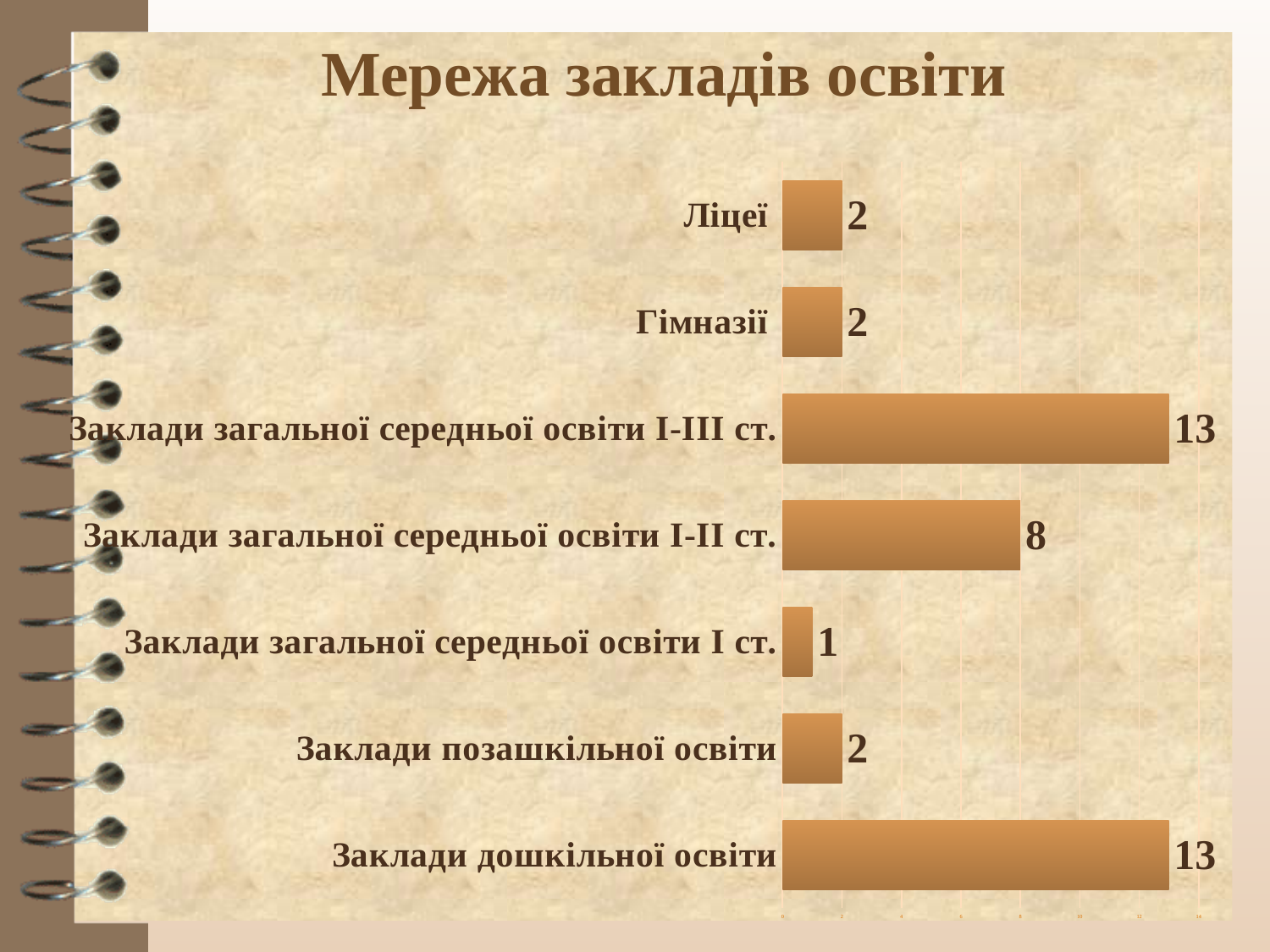
What is the value for Заклади дошкільної освіти? 13 What is the title of the chart? Мережа закладів освіти What is the difference between Заклади загальної середньої освіти І-ІІІ ст. and Заклади загальної середньої освіти І-ІІ ст.? 5 What is the value for Гімназії? 2 How many categories are shown in the chart? 7 What is the value for Заклади загальної середньої освіти І-ІІ ст.? 8 What is the highest value shown in the chart? 13 What is the value for Заклади загальної середньої освіти І ст.? 1 What is the value for Ліцеї? 2 Which is larger: Заклади загальної середньої освіти І-ІІ ст. or Заклади позашкільної освіти? Заклади загальної середньої освіти І-ІІ ст. What kind of chart is shown on the slide? bar chart Which category has the lowest value? Заклади загальної середньої освіти І ст.